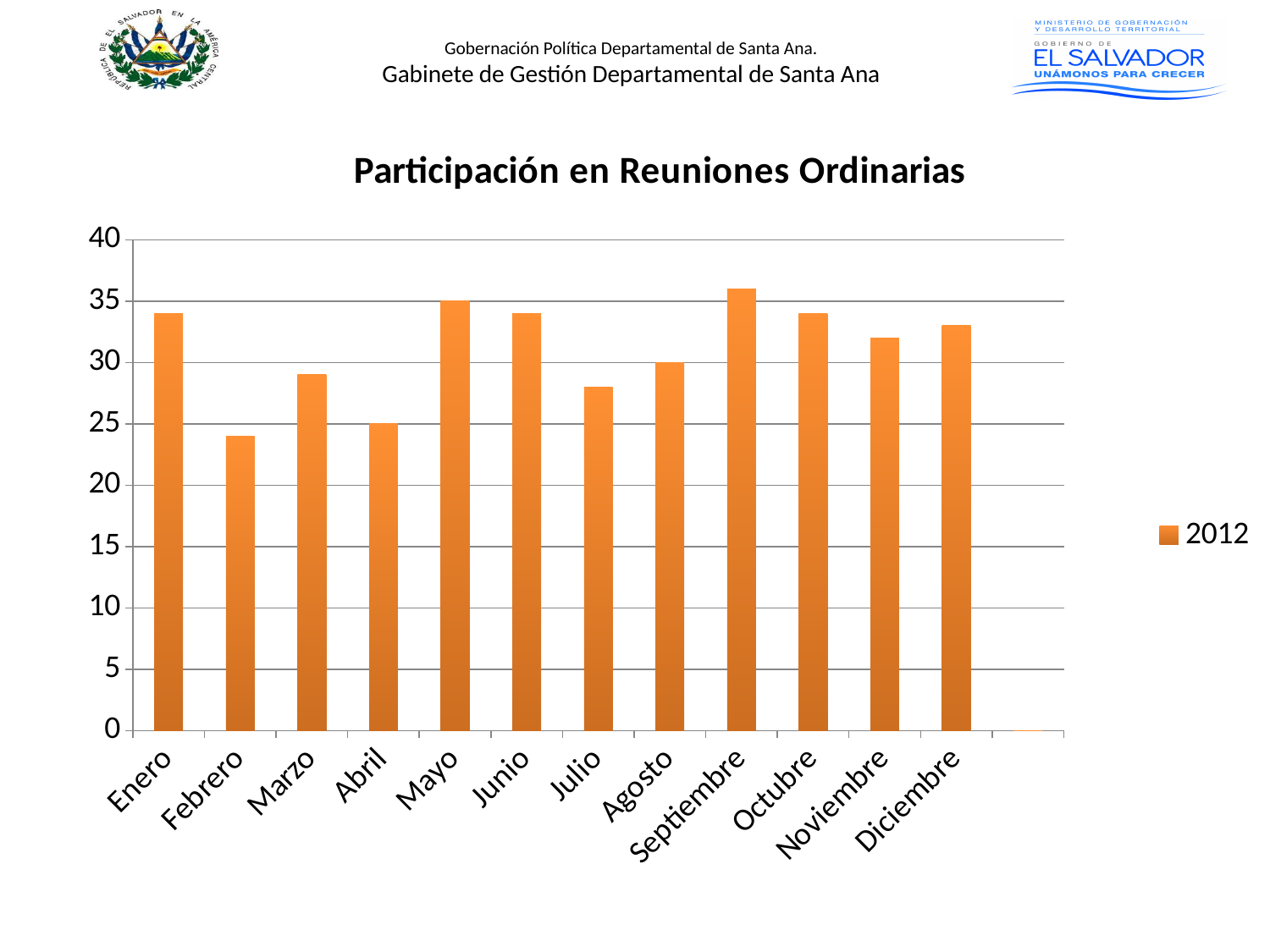
What is the value for Mayo? 35 Which month has the highest value? Septiembre Is the value for Febrero greater or less than 25? less How many months are shown on the x axis? 12 What is the value for Abril? 25 How many series does the legend list? 1 Is the value for Julio greater or less than 30? less Which is larger, the value for Enero or the value for Julio? Enero What is the title of the chart? Participación en Reuniones Ordinarias What is the value for Agosto? 30 What is the legend entry for the series? 2012 What type of chart is shown on the slide? Bar chart